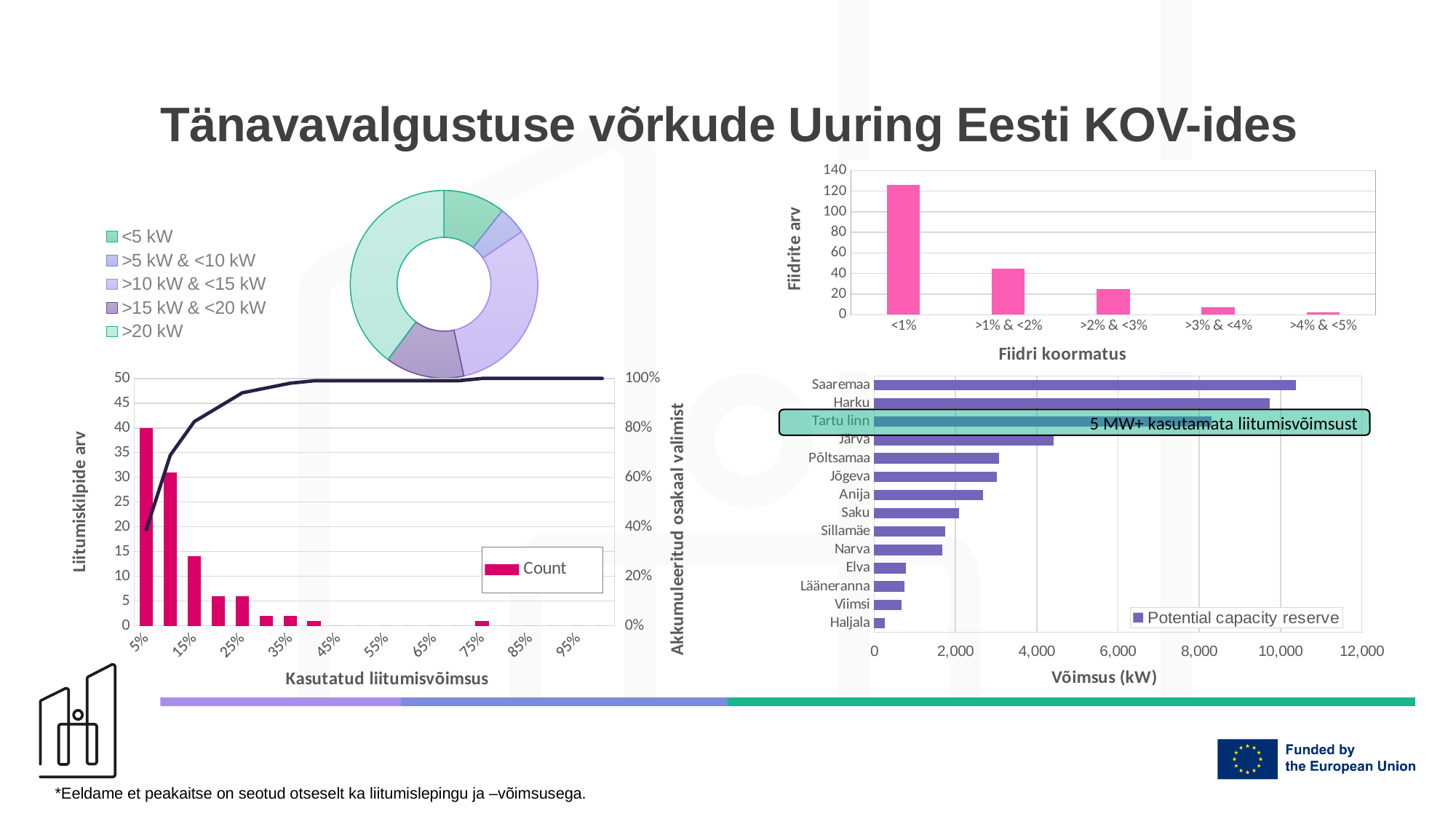
In the top-right chart (Fiidri koormatus), which category has the lowest value? >4% & <5% In the top-right chart (Fiidri koormatus), is the value for <1% greater or less than 100? greater In the top-right chart (Fiidri koormatus), how many categories are shown on the x axis? 5 In the bottom-right chart (Võimsus (kW)), is the value for Saaremaa greater or less than 10,000? greater In the bottom-right chart (Võimsus (kW)), which is larger, the value for Järva or the value for Põltsamaa? Järva In the bottom-right chart (Võimsus (kW)), which municipality has the largest potential capacity reserve? Saaremaa How many entries does the legend of the donut chart list? 5 In the bottom-left chart (Kasutatud liitumisvõimsus), which category has the tallest bar? 5% In the bottom-left chart (Kasutatud liitumisvõimsus), is the bar for 5% greater or less than 35? greater In the bottom-right chart (Võimsus (kW)), which municipality has the smallest potential capacity reserve? Haljala In the top-right chart (Fiidri koormatus), which category has the highest number of feeders (Fiidrite arv)? <1% In the bottom-right chart (Võimsus (kW)), how many municipalities are listed? 14